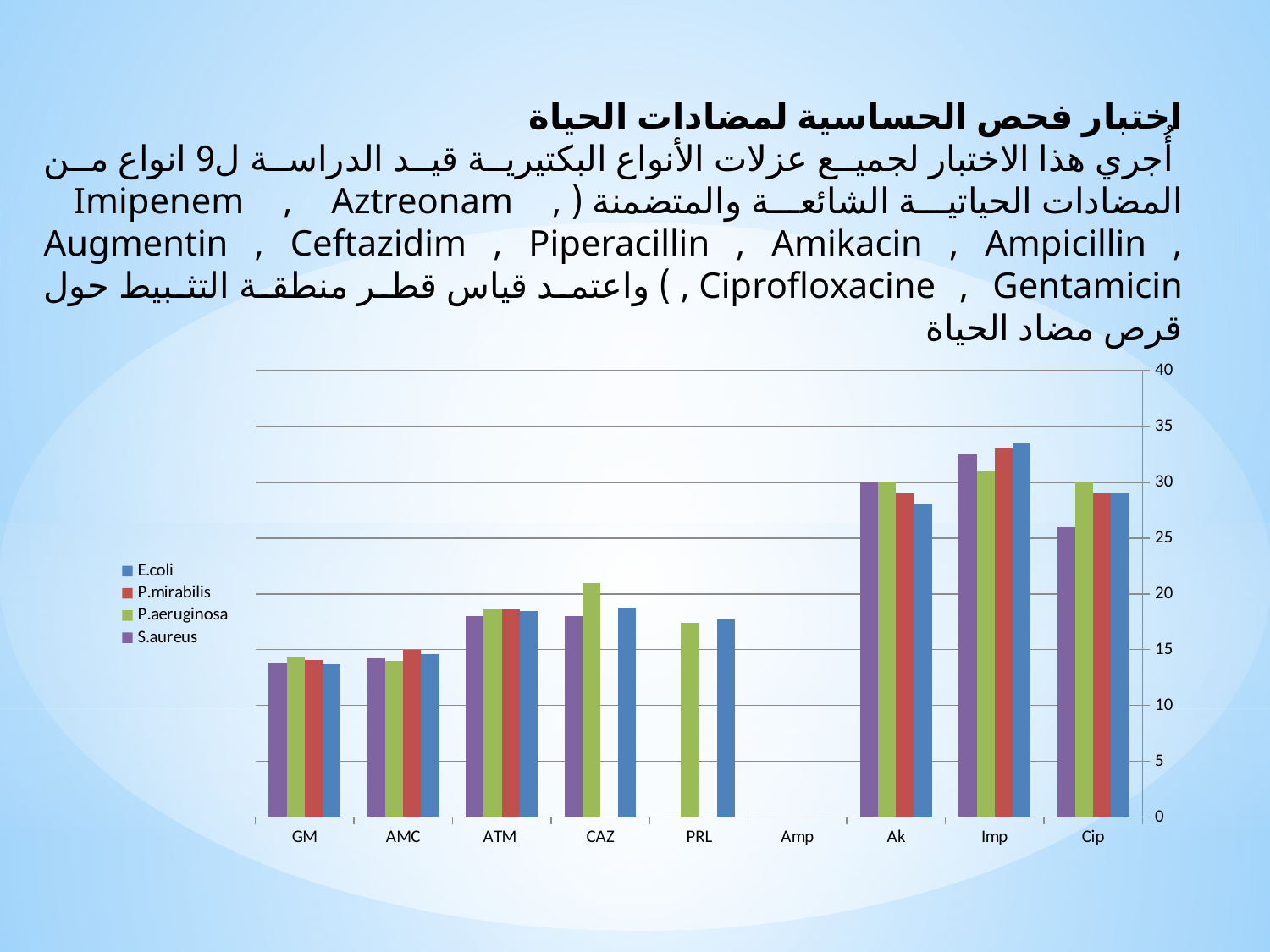
What kind of chart is shown on the slide? bar chart Is the value for S.aureus at Ak greater or less than 25? greater How many series does the chart legend list? 4 Is the value for E.coli at GM greater or less than 15? less Which category on the x axis has no bars plotted? Amp Is the value for S.aureus at Cip greater or less than 30? less How many antibiotic categories are shown on the x axis of the chart? 9 At CAZ, which is larger: the P.aeruginosa bar or the S.aureus bar? P.aeruginosa Which bacterial species are listed in the chart legend? E.coli, P.mirabilis, P.aeruginosa, S.aureus Which category has the highest E.coli bar? Imp